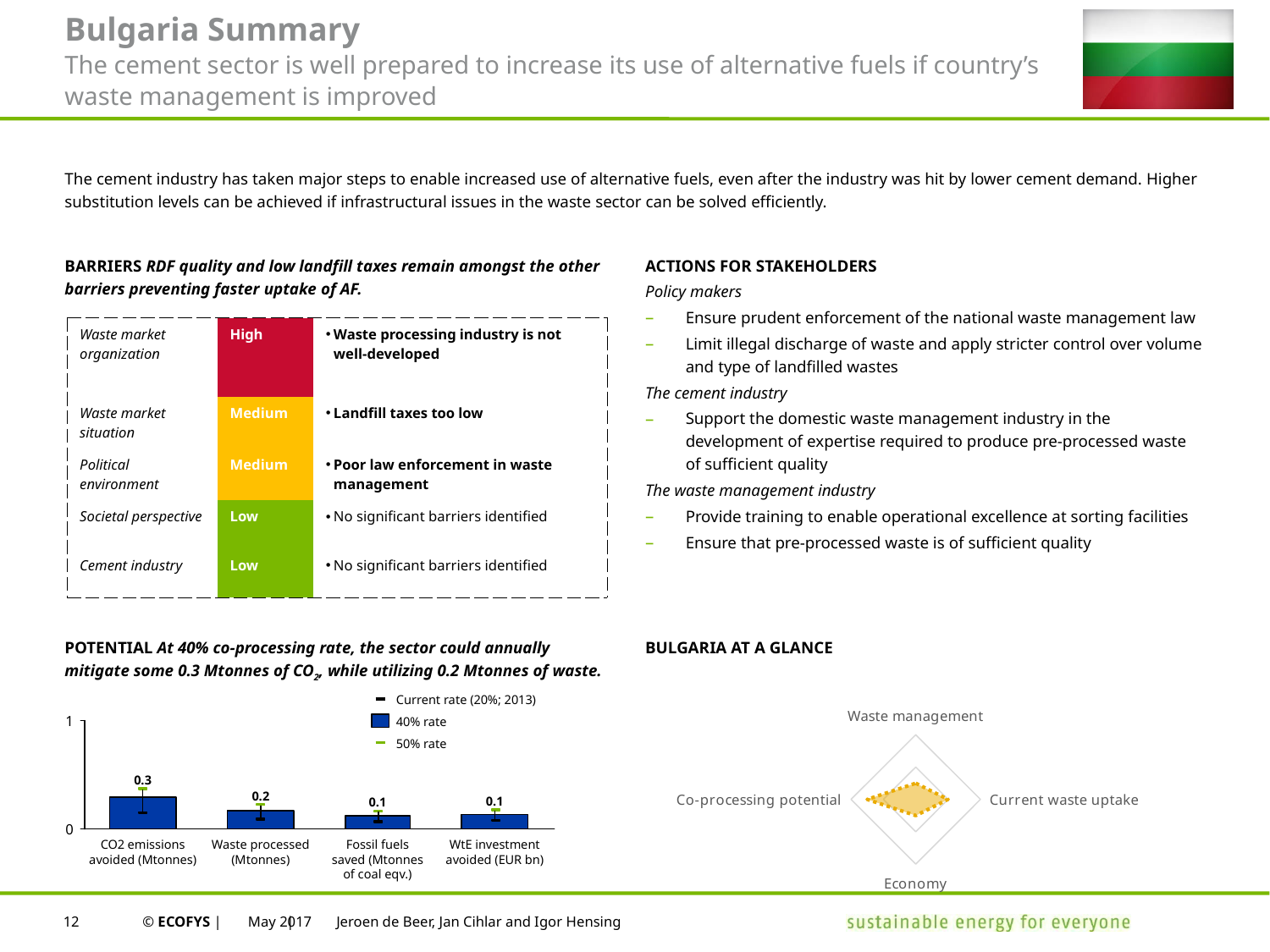
What kind of chart is shown at the bottom left of the slide? Bar chart In the bar chart at the bottom left, what is the difference between the CO2 emissions avoided bar and the Waste processed bar? 0.1 In the bar chart at the bottom left, what is the value for Fossil fuels saved (Mtonnes of coal eqv.)? 0.1 In the bar chart at the bottom left, which category has the highest bar? CO2 emissions avoided (Mtonnes) In the bar chart at the bottom left, what is the value for WtE investment avoided (EUR bn)? 0.1 In the 'Bulgaria at a glance' chart at the bottom right, what are the four axis labels? Waste management, Current waste uptake, Economy, Co-processing potential How many categories are shown on the x axis of the bar chart at the bottom left? 4 In the bar chart at the bottom left, is the value for CO2 emissions avoided greater or less than 1? less In the bar chart at the bottom left, which is larger: the bar for CO2 emissions avoided or the bar for Fossil fuels saved? CO2 emissions avoided In the bar chart at the bottom left, what is the value for CO2 emissions avoided (Mtonnes) at the 40% rate? 0.3 How many entries does the legend of the bar chart at the bottom left list? 3 In the bar chart at the bottom left, what is the value for Waste processed (Mtonnes)? 0.2